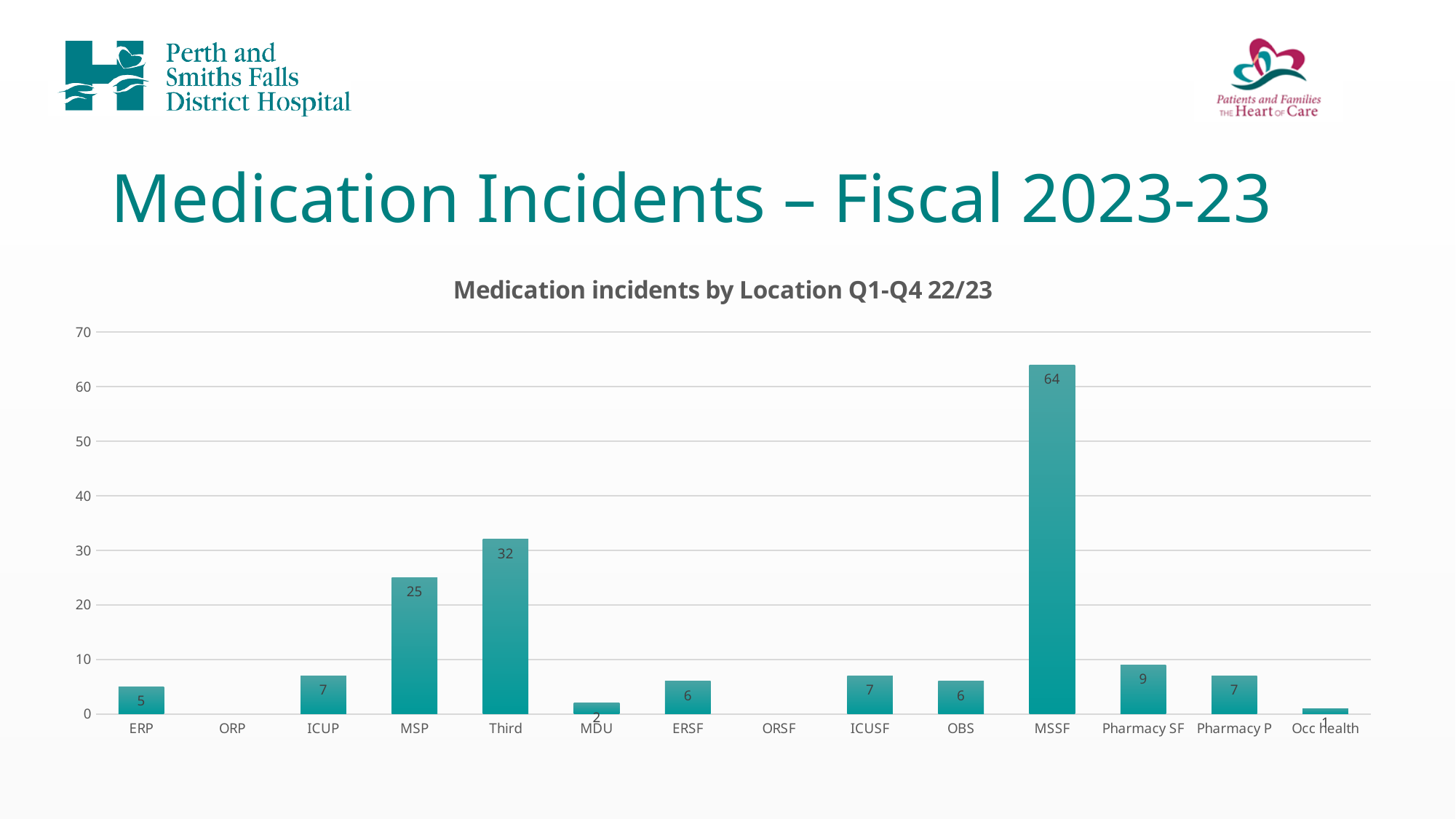
Which location has the highest number of medication incidents? MSSF What is the value for Pharmacy SF? 9 What is the value for MSP? 25 How many medication incidents are shown for Third? 32 What is the difference between the values for Third and MSP? 7 Is the value for MSSF greater or less than 60? greater What is the value for MDU? 2 What is the difference between the values for MSSF and Third? 32 What is the value for MSSF in the Medication incidents by Location chart? 64 How many location categories are shown on the x axis? 14 Which is larger, the value for MSP or the value for Pharmacy SF? MSP What kind of chart is shown on the slide? bar chart